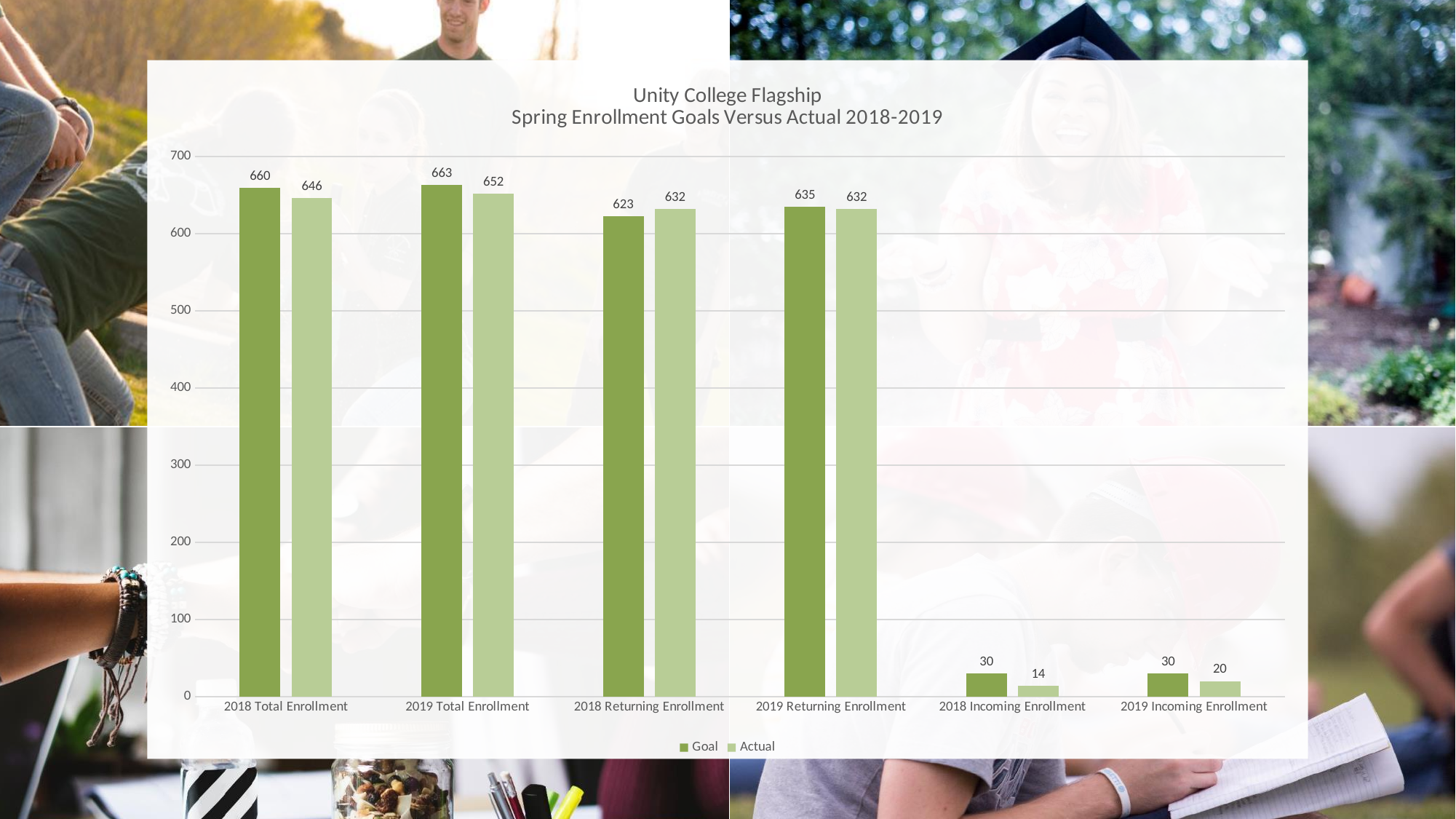
Which category has the highest Goal value? 2019 Total Enrollment What is the difference between the Goal and Actual values for 2018 Total Enrollment? 14 Which is larger for 2018 Returning Enrollment, the Goal or the Actual value? Actual What kind of chart is shown on the slide? Bar chart What is the Actual value for 2018 Incoming Enrollment? 14 What is the Actual value for 2019 Total Enrollment? 652 What is the title of the chart? Unity College Flagship Spring Enrollment Goals Versus Actual 2018-2019 What is the Goal value for 2019 Returning Enrollment? 635 How many series does the legend list? 2 Which category has the lowest Actual value? 2018 Incoming Enrollment How many categories are shown on the x axis? 6 What is the Goal value for 2018 Total Enrollment? 660